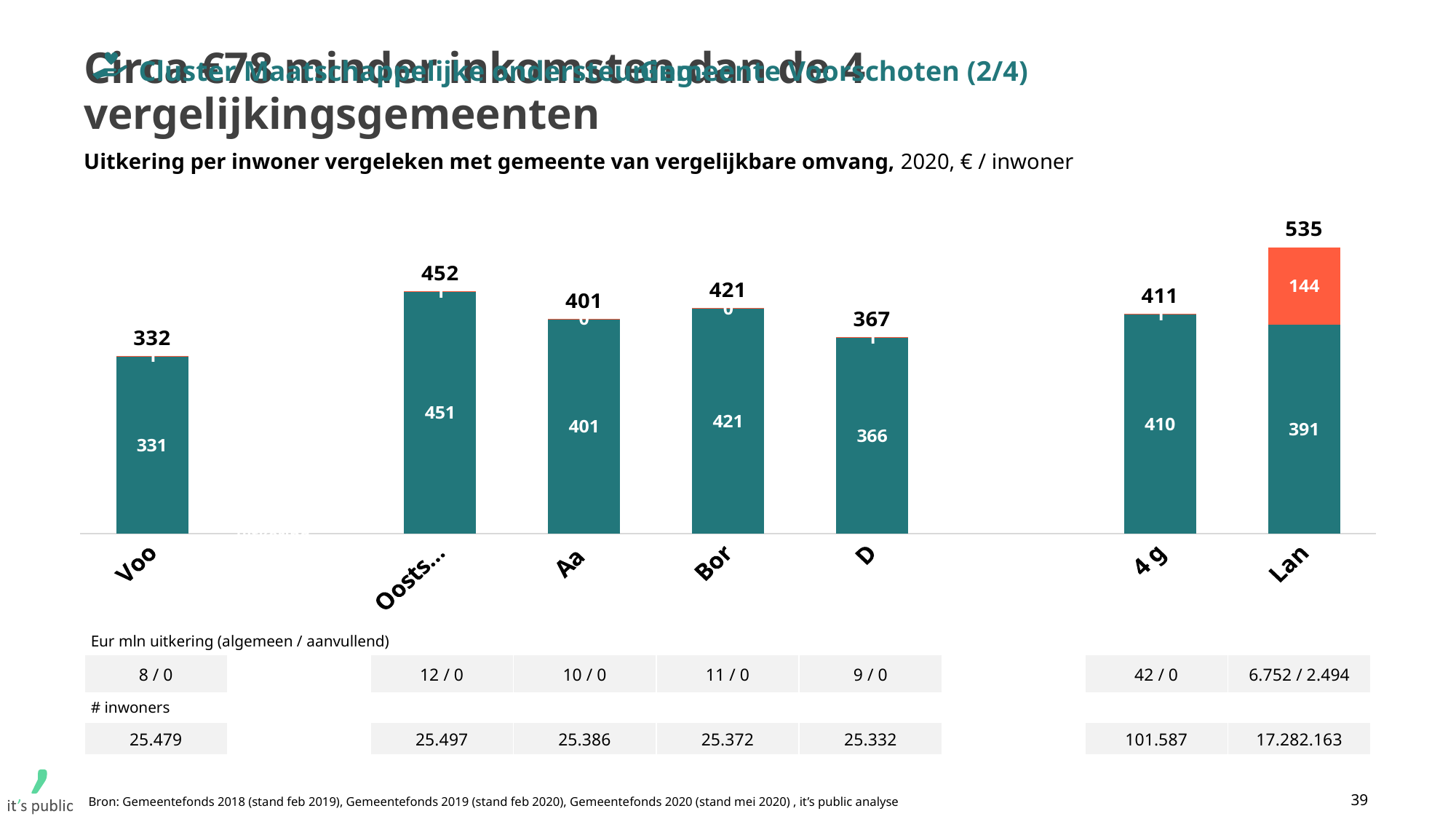
What is the value of the teal segment of the Lan bar? 391 How many bars are plotted in the chart? 7 What is the total value shown above the bar for Voo? 332 What is the value of the orange (top) segment of the Lan bar? 144 What is the difference between the total for Oosts... and the total for Aa? 51 What is the difference between the total for Lan and the total for Voo? 203 What is the total value shown above the bar for D? 367 Which category has the highest total value? Lan What kind of chart is shown on the slide? Stacked bar chart Which has a higher total, Bor or 4 g? Bor Which category has the lowest total value? Voo What is the total value shown above the bar for Lan? 535